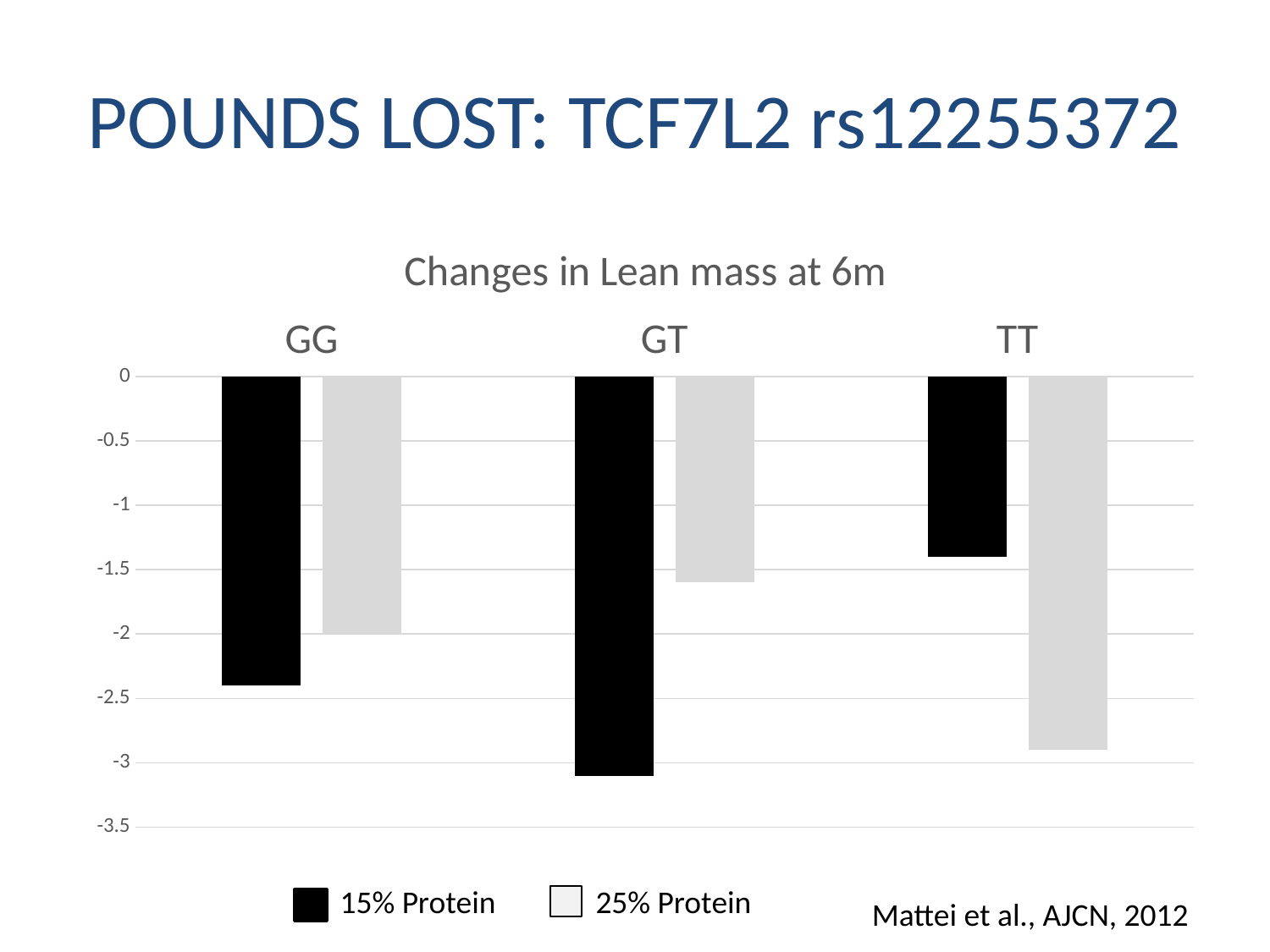
Is the value for 25% Protein in the GT group greater or less than -2? greater What type of chart is shown on the slide? bar chart Is the value for 25% Protein in the TT group greater or less than -2.5? less In the TT group, which series has the bar extending further below zero, 15% Protein or 25% Protein? 25% Protein How many genotype categories are shown on the x axis? 3 How many series does the legend list? 2 Which series is drawn in black? 15% Protein Is the value for 15% Protein in the GT group greater or less than -3? less What is the title of the chart? Changes in Lean mass at 6m Which bar extends furthest below zero in the chart? 15% Protein in the GT group